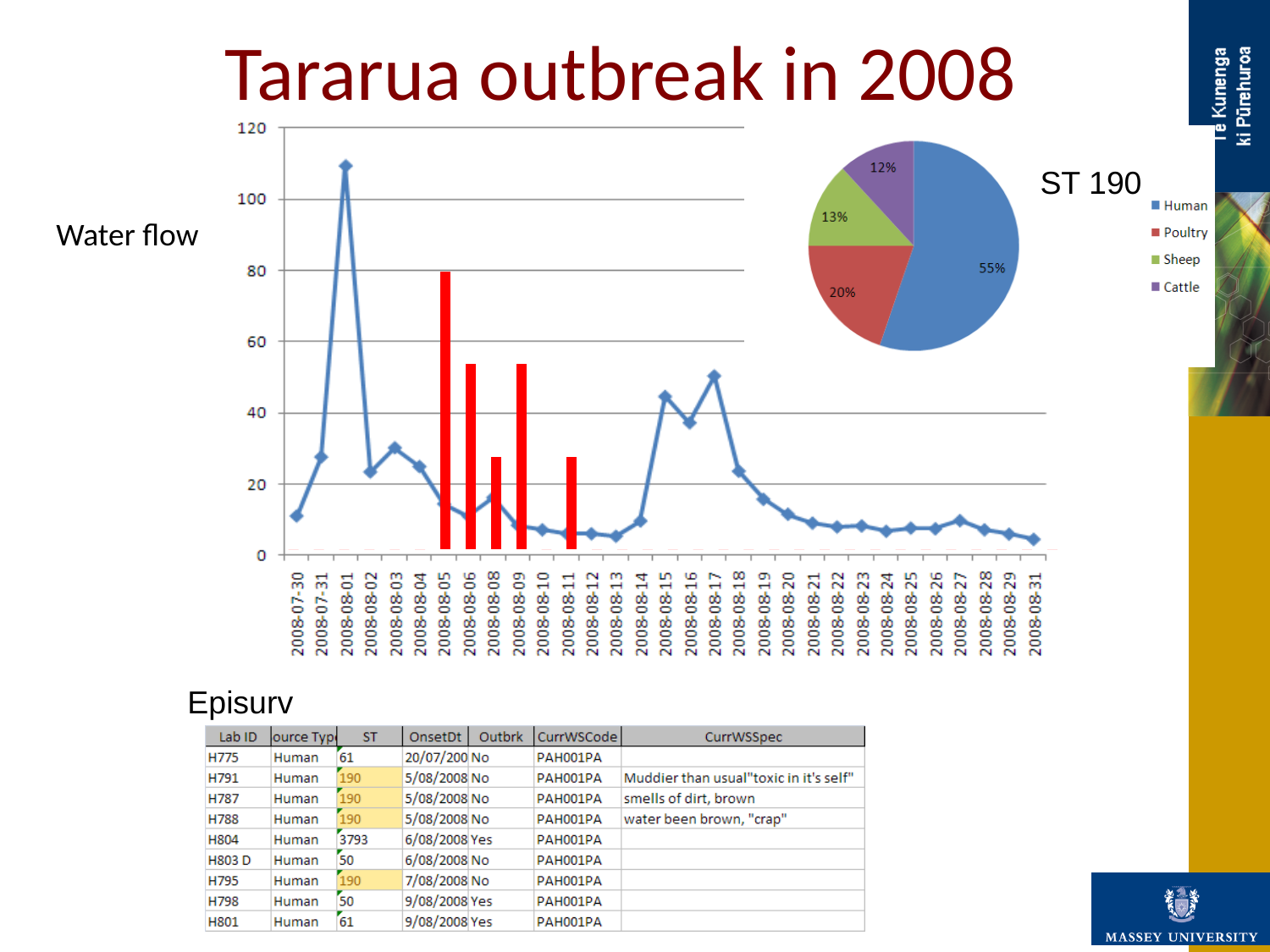
In the pie chart labelled ST 190, which category has the largest slice? Human How many categories does the legend of the ST 190 pie chart list? 4 How many red bars are overlaid on the water flow line chart? 5 In the pie chart labelled ST 190, what is the difference between the Human and Poultry shares? 35% In the water flow line chart, is the value on 2008-08-31 greater or less than 20? less What kind of chart is the ST 190 chart in the top right? Pie chart In the water flow line chart, on which date does the line reach its highest value? 2008-08-01 In the water flow line chart, is the value on 2008-08-01 greater or less than 100? greater In the pie chart labelled ST 190, which category has the smallest slice? Cattle In the pie chart labelled ST 190, what share is Poultry? 20% In the pie chart labelled ST 190, what share is Human? 55% In the pie chart labelled ST 190, what share is Sheep? 13%